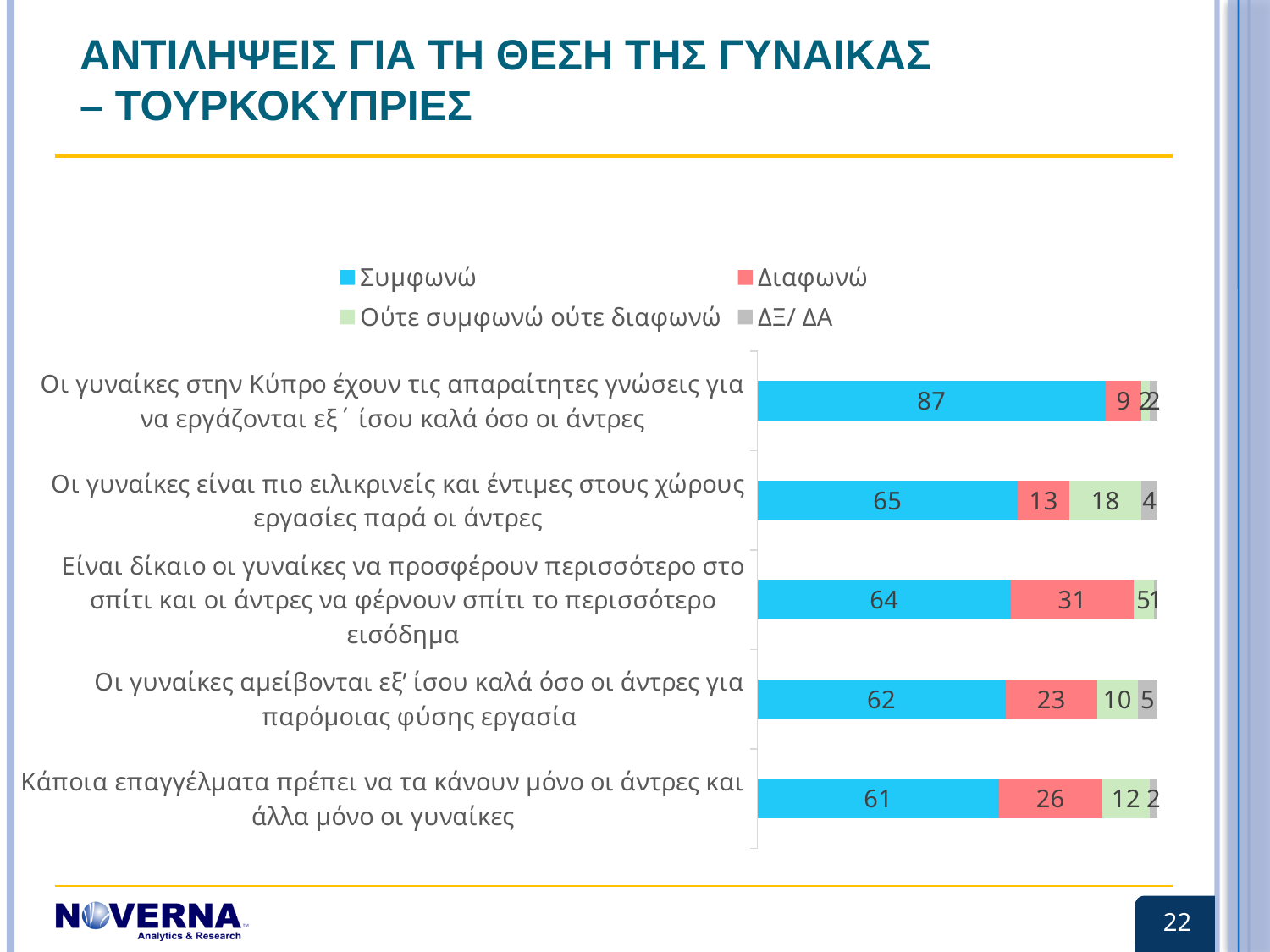
How many series does the legend list? 4 Which is larger: the Διαφωνώ value for 'Κάποια επαγγέλματα πρέπει να τα κάνουν μόνο οι άντρες και άλλα μόνο οι γυναίκες' or for 'Οι γυναίκες αμείβονται εξ’ ίσου καλά όσο οι άντρες για παρόμοιας φύσης εργασία'? Κάποια επαγγέλματα πρέπει να τα κάνουν μόνο οι άντρες και άλλα μόνο οι γυναίκες What is the Ούτε συμφωνώ ούτε διαφωνώ value for the statement 'Οι γυναίκες είναι πιο ειλικρινείς και έντιμες στους χώρους εργασίες παρά οι άντρες'? 18 What is the Διαφωνώ value for the statement 'Είναι δίκαιο οι γυναίκες να προσφέρουν περισσότερο στο σπίτι και οι άντρες να φέρνουν σπίτι το περισσότερο εισόδημα'? 31 What is the ΔΞ/ΔΑ value for the statement 'Οι γυναίκες αμείβονται εξ’ ίσου καλά όσο οι άντρες για παρόμοιας φύσης εργασία'? 5 Which statement has the lowest Συμφωνώ value? Κάποια επαγγέλματα πρέπει να τα κάνουν μόνο οι άντρες και άλλα μόνο οι γυναίκες Which statement has the highest Συμφωνώ value? Οι γυναίκες στην Κύπρο έχουν τις απαραίτητες γνώσεις για να εργάζονται εξ΄ ίσου καλά όσο οι άντρες What type of chart is shown on the slide? stacked bar chart What is the difference between the Συμφωνώ values for 'Οι γυναίκες στην Κύπρο έχουν τις απαραίτητες γνώσεις...' (87) and 'Κάποια επαγγέλματα πρέπει να τα κάνουν μόνο οι άντρες...' (61)? 26 What is the Συμφωνώ value for the statement 'Οι γυναίκες στην Κύπρο έχουν τις απαραίτητες γνώσεις για να εργάζονται εξ΄ ίσου καλά όσο οι άντρες'? 87 Which legend entry is shown in blue? Συμφωνώ How many statements (categories) are plotted in the chart? 5